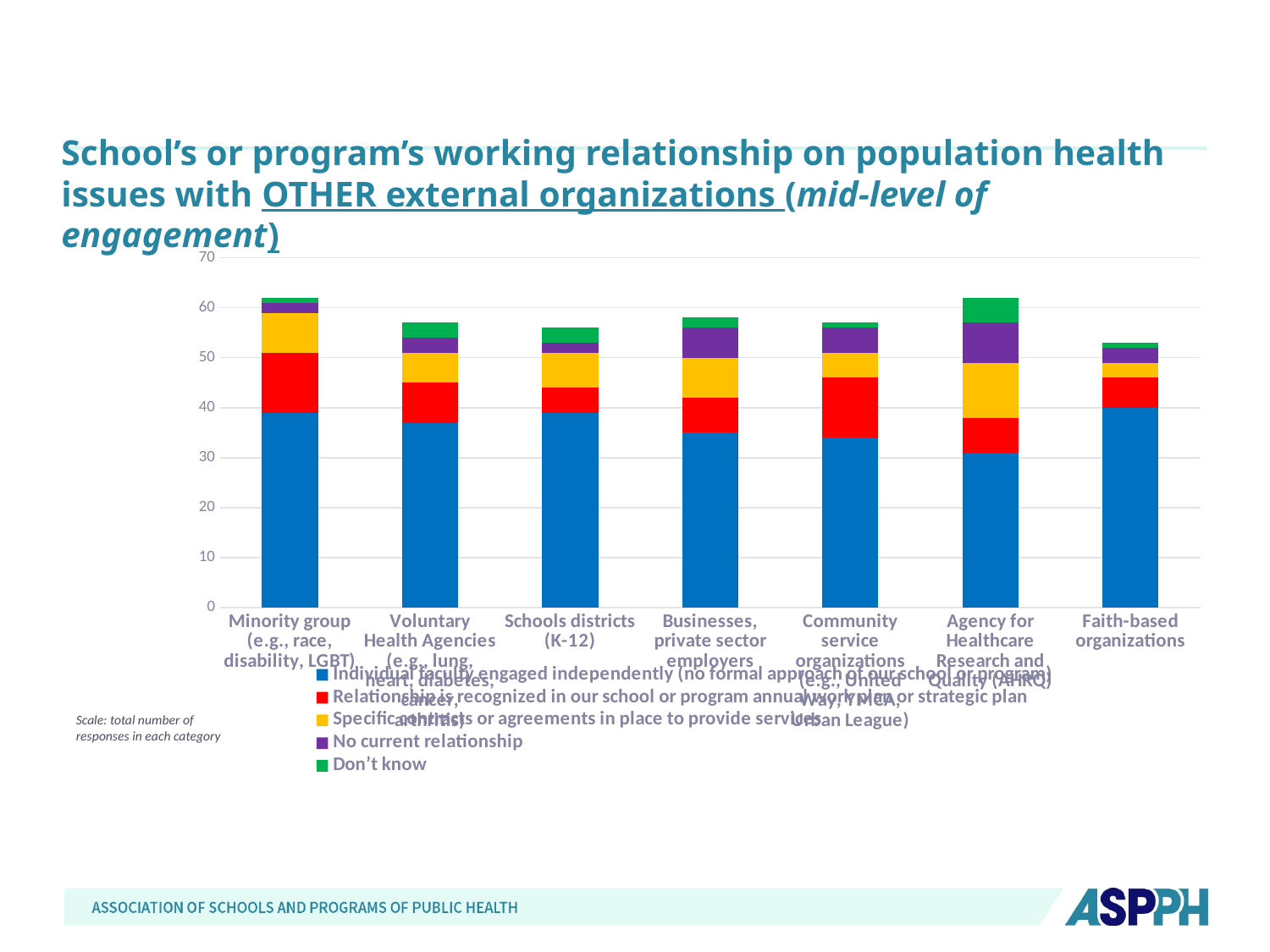
How many series does the legend list? 5 Is the total height of the bar for Businesses, private sector employers greater or less than 50? greater Is the 'Individual faculty engaged independently' segment for Faith-based organizations greater or less than 30? greater Is the total height of the bar for Faith-based organizations greater or less than 60? less Which colour represents the 'Don't know' series in the legend? Green How many external organization categories are shown on the x axis? 7 Which category has the smallest 'Individual faculty engaged independently' (blue) segment? Agency for Healthcare Research and Quality (AHRQ) Which has the larger 'Specific contracts or agreements in place to provide services' segment: Agency for Healthcare Research and Quality (AHRQ) or Faith-based organizations? Agency for Healthcare Research and Quality (AHRQ) Which has the larger 'Relationship is recognized in our school or program annual work plan or strategic plan' segment: Minority group or Faith-based organizations? Minority group What kind of chart is shown on the slide? Stacked bar chart